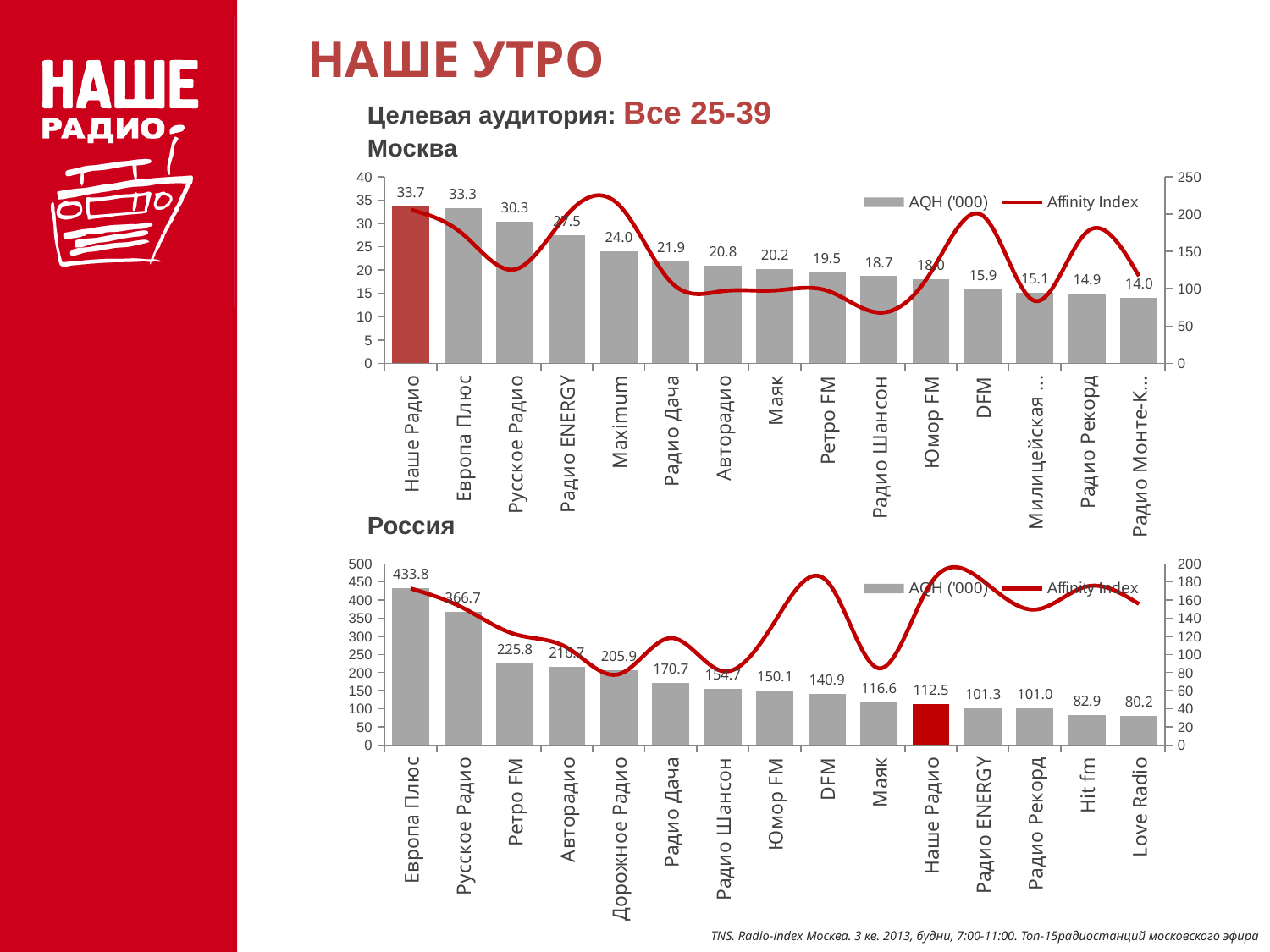
In the Москва chart, how many radio stations are shown on the x axis? 15 In the Россия chart, what is the AQH ('000) value for Наше Радио? 112.5 In the Россия chart, which station has the lowest AQH ('000) bar? Love Radio In the Москва chart, what is the difference in AQH ('000) between Наше Радио and Европа Плюс? 0.4 In the Россия chart, do the AQH ('000) bars rise or fall from left to right along the x axis? fall In the Россия chart, which has a larger AQH ('000) value, Русское Радио or Ретро FM? Русское Радио In the Москва chart, what is the AQH ('000) value for Maximum? 24.0 In the Россия chart, what is the difference in AQH ('000) between Европа Плюс and Русское Радио? 67.1 In the Москва chart, which station has the highest AQH ('000) bar? Наше Радио In the Москва chart, what is the AQH ('000) value for Наше Радио? 33.7 In the Россия chart, what is the AQH ('000) value for Европа Плюс? 433.8 In the Москва chart, how many series does the legend list? 2